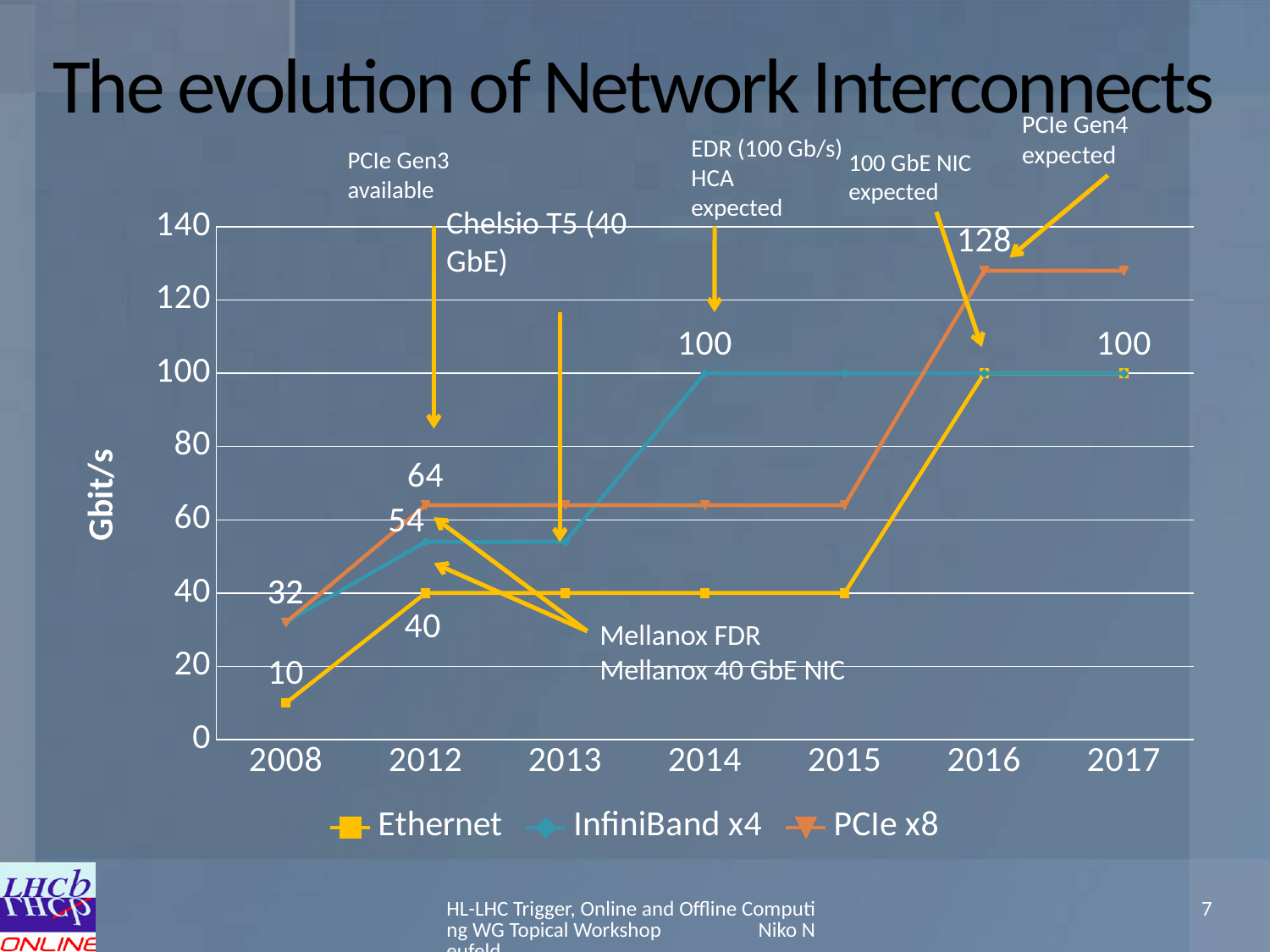
What is the Ethernet value in 2017? 100 How many years are shown on the x axis? 7 What is the PCIe x8 value in 2016? 128 Which series has the highest value in 2016? PCIe x8 What is the label of the y axis? Gbit/s What is the InfiniBand x4 value in 2012? 54 What is the PCIe x8 value in 2008? 32 What kind of chart is shown on the slide? line chart Is the PCIe x8 value in 2014 greater or less than 80? less How many series does the legend list? 3 What is the Ethernet value in 2008? 10 What is the difference between the PCIe x8 value and the Ethernet value in 2012? 24